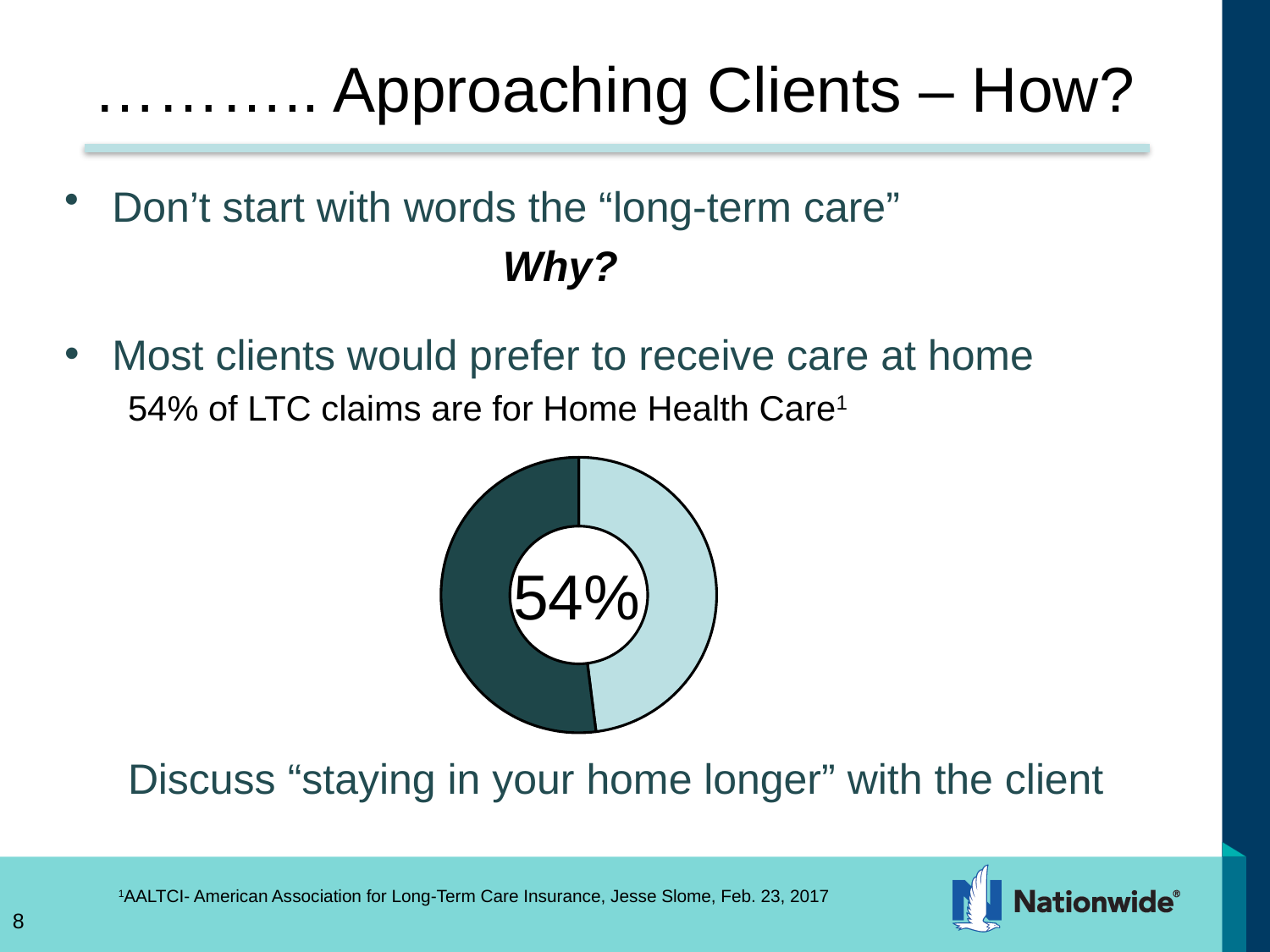
Which slice of the donut chart is larger, the light blue one or the dark teal one? The dark teal one Is the Home Health Care share of LTC claims greater or less than 50%? greater Does the donut chart include a legend? No What colour is the larger slice of the donut chart? Dark teal What percentage is printed in the centre of the donut chart? 54% How many slices does the donut chart have? 2 According to the slide, what share of LTC claims are for Home Health Care? 54% What kind of chart is shown on the slide? Donut (pie) chart